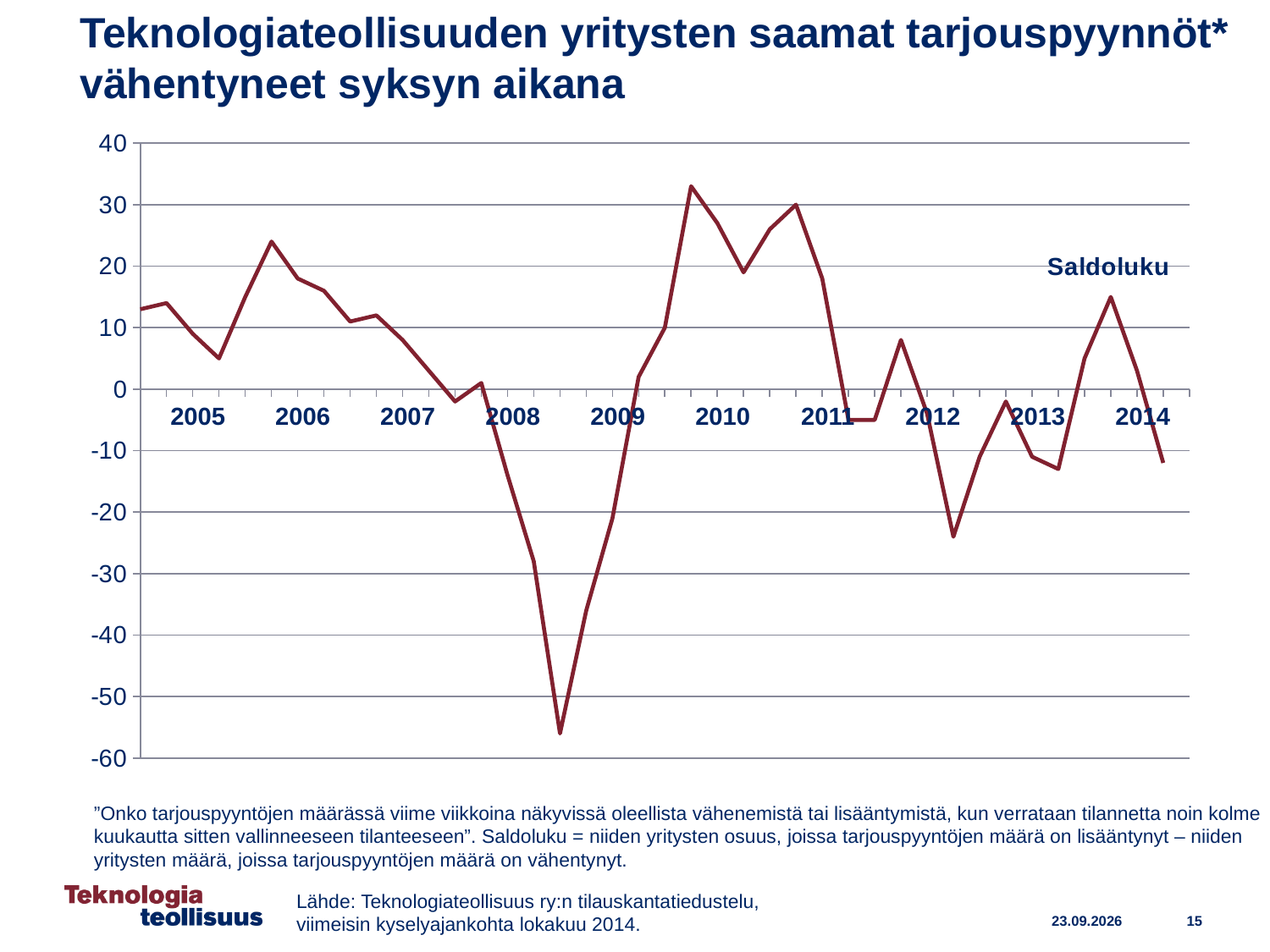
What is the lowest value shown on the y axis? -60 Is the lowest value reached in 2012 greater or less than -20? less Does the line rise or fall from its 2014 peak to the final point? fall What kind of chart is shown on the slide? line chart Is the last value of the line, in 2014, greater or less than 0? less Is the lowest value of the line greater or less than -50? less What is the name of the series labelled on the chart? Saldoluku In which year does the line reach its lowest point? 2009 How many year labels are shown on the x axis? 10 Which is lower, the trough in 2008 or the trough in 2012? 2008